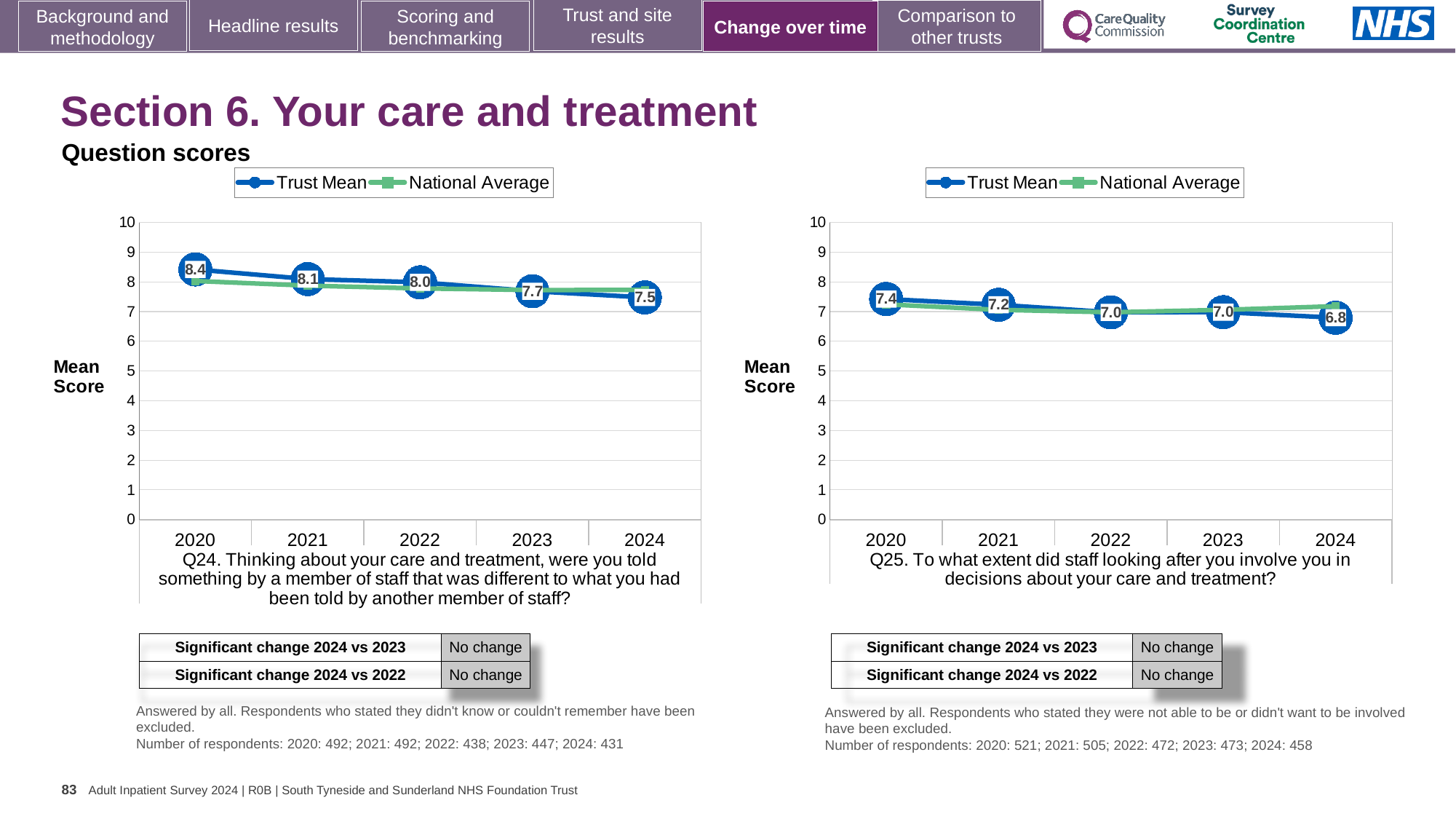
On the Q24 chart (left), does the Trust Mean score rise or fall from 2020 to 2024? fall On the Q25 chart (right), which year has the lowest Trust Mean score? 2024 How many years are plotted on the x axis of the Q25 chart (right)? 5 On the Q25 chart (right), what is the Trust Mean score for 2024? 6.8 On the Q24 chart (left), what is the Trust Mean score for 2020? 8.4 Which is larger: the 2022 Trust Mean on the Q24 chart (left) or the 2022 Trust Mean on the Q25 chart (right)? Q24 chart (left) How many series does the legend of the Q24 chart (left) list? 2 On the Q24 chart (left), what is the difference between the Trust Mean scores for 2020 and 2024? 0.9 On the Q24 chart (left), which year has the highest Trust Mean score? 2020 On the Q24 chart (left), what is the Trust Mean score for 2024? 7.5 On the Q25 chart (right), what is the Trust Mean score for 2021? 7.2 On the Q25 chart (right), what is the difference between the Trust Mean scores for 2020 and 2022? 0.4